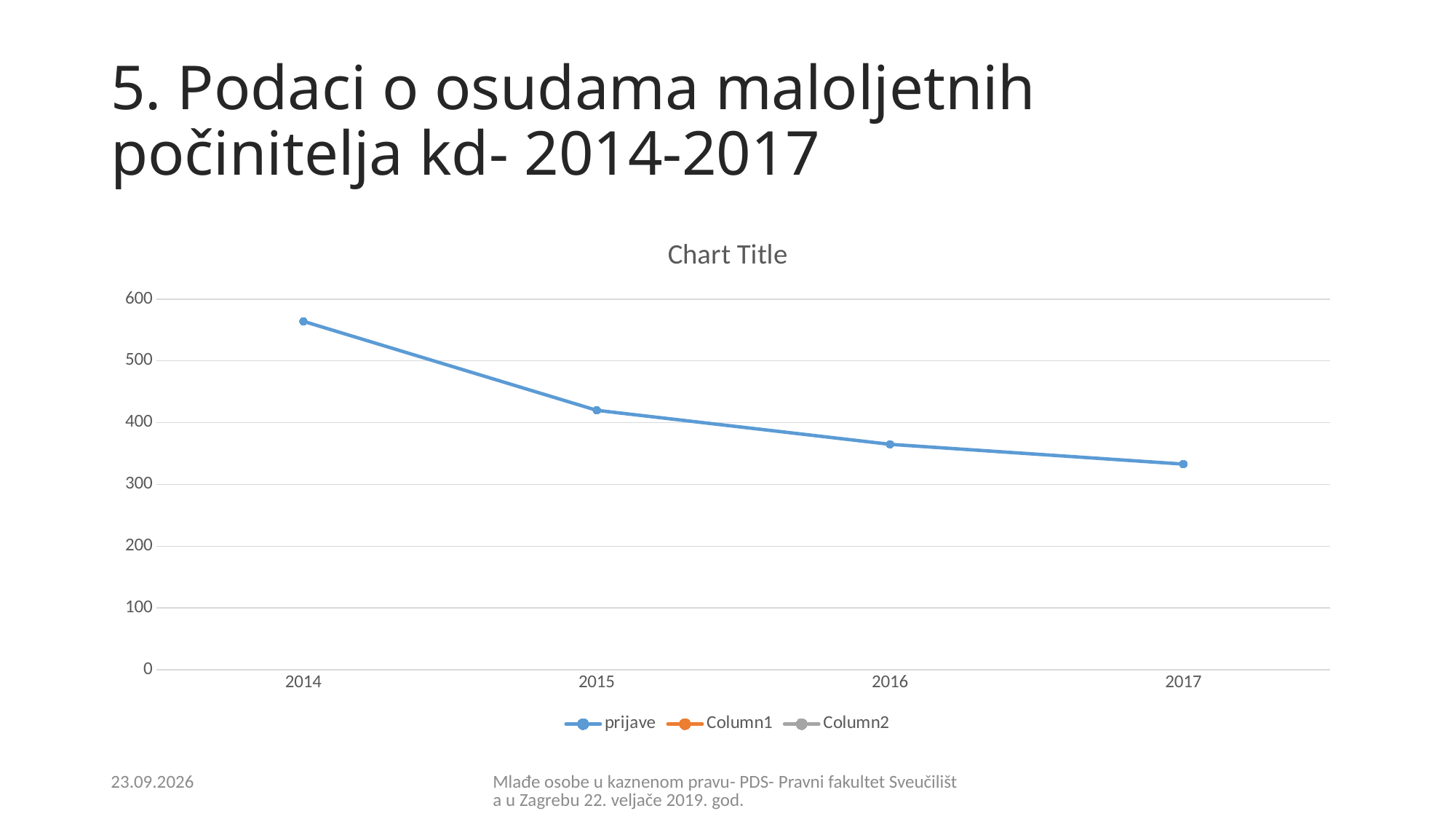
Is the value for prijave in 2017 greater or less than 300? greater Which year has the lowest value for prijave? 2017 Which is larger, the value for prijave in 2015 or in 2016? 2015 Do the values for prijave rise or fall from 2014 to 2017? fall Is the value for prijave in 2016 greater or less than 400? less Is the value for prijave in 2014 greater or less than 500? greater What kind of chart is shown on the slide? line chart How many years are plotted on the x axis? 4 How many series does the legend list? 3 What is the title shown above the chart? Chart Title Which year has the highest value for prijave? 2014 What is the name of the first series in the legend? prijave